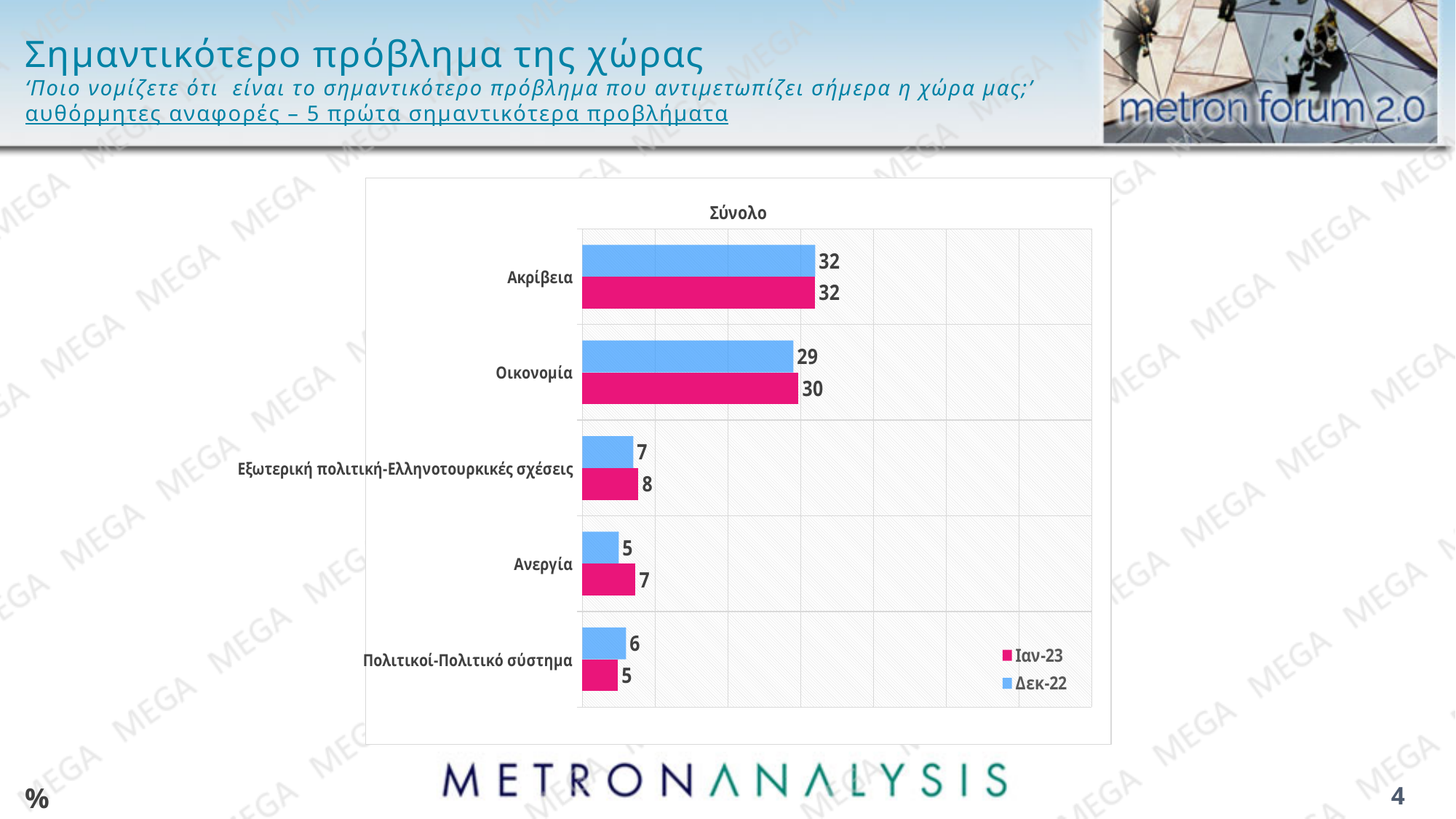
What is the title of the chart? Σύνολο How many categories are shown in the chart? 5 For Πολιτικοί-Πολιτικό σύστημα, which series has the larger value, Ιαν-23 or Δεκ-22? Δεκ-22 What is the value for Ανεργία in the Δεκ-22 series? 5 Which category has the highest value in the Ιαν-23 series? Ακρίβεια What is the difference between the Ιαν-23 values for Ακρίβεια and Οικονομία? 2 Which category has the lowest value in the Ιαν-23 series? Πολιτικοί-Πολιτικό σύστημα What kind of chart is shown on the slide? Bar chart What is the value for Οικονομία in the Ιαν-23 series? 30 How many series does the legend list? 2 What is the difference between the Ιαν-23 and Δεκ-22 values for Ανεργία? 2 What is the value for Εξωτερική πολιτική-Ελληνοτουρκικές σχέσεις in the Ιαν-23 series? 8